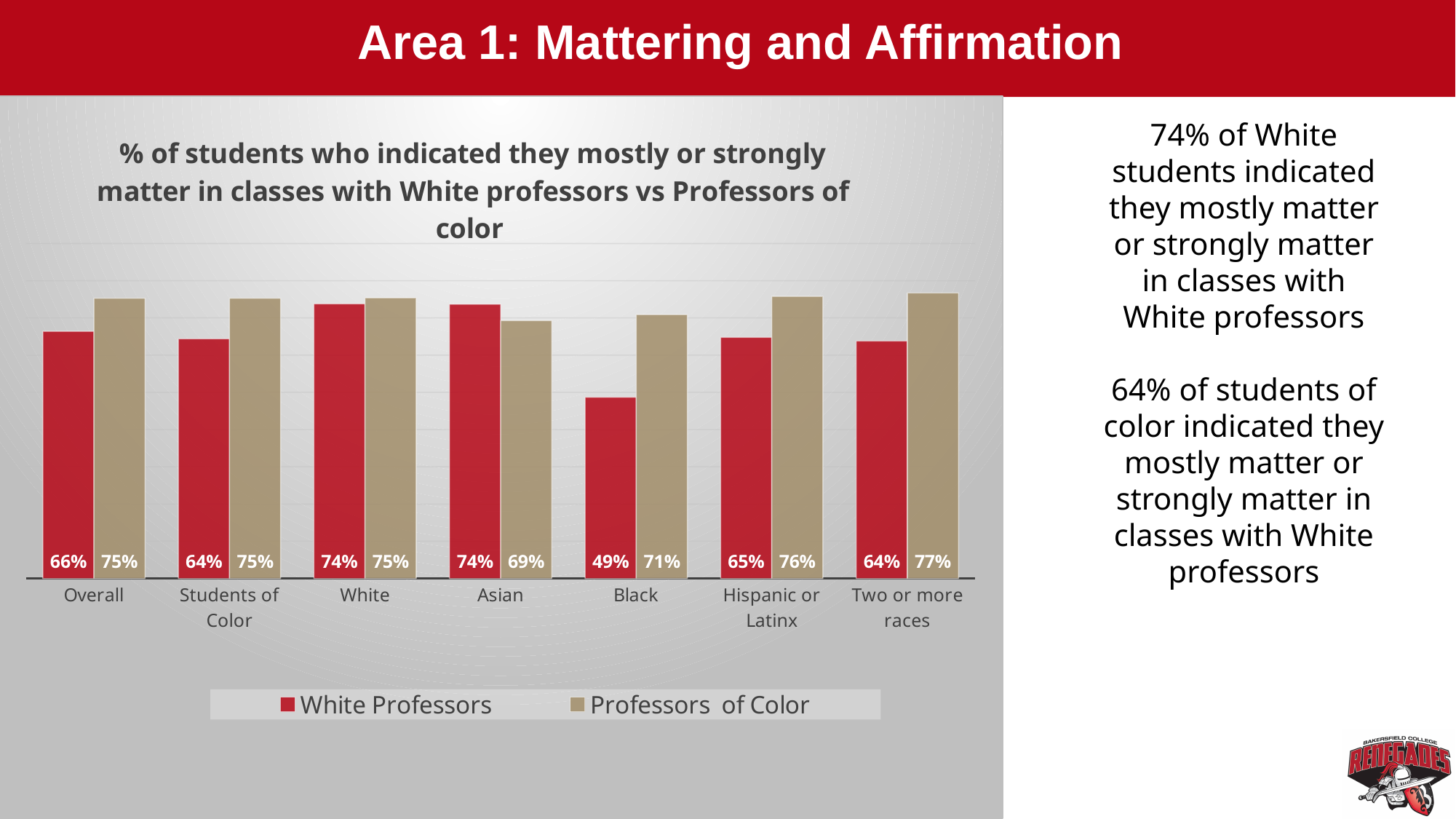
Which colour represents the White Professors series in the legend? Red Which category has the lowest value for White Professors? Black Which category has the highest value for Professors of Color? Two or more races What kind of chart is shown on the slide? Bar chart What is the Overall value for Professors of Color? 75% How many series does the legend list? 2 What percentage of Black students indicated they mostly or strongly matter in classes with White professors? 49% What is the difference between the Professors of Color and White Professors values for Black students? 22% For Asian students, which is larger: the White Professors value or the Professors of Color value? White Professors What is the difference between the Hispanic or Latinx values for Professors of Color and White Professors? 11% What is the value for Two or more races in the Professors of Color series? 77% How many categories are shown on the x axis? 7